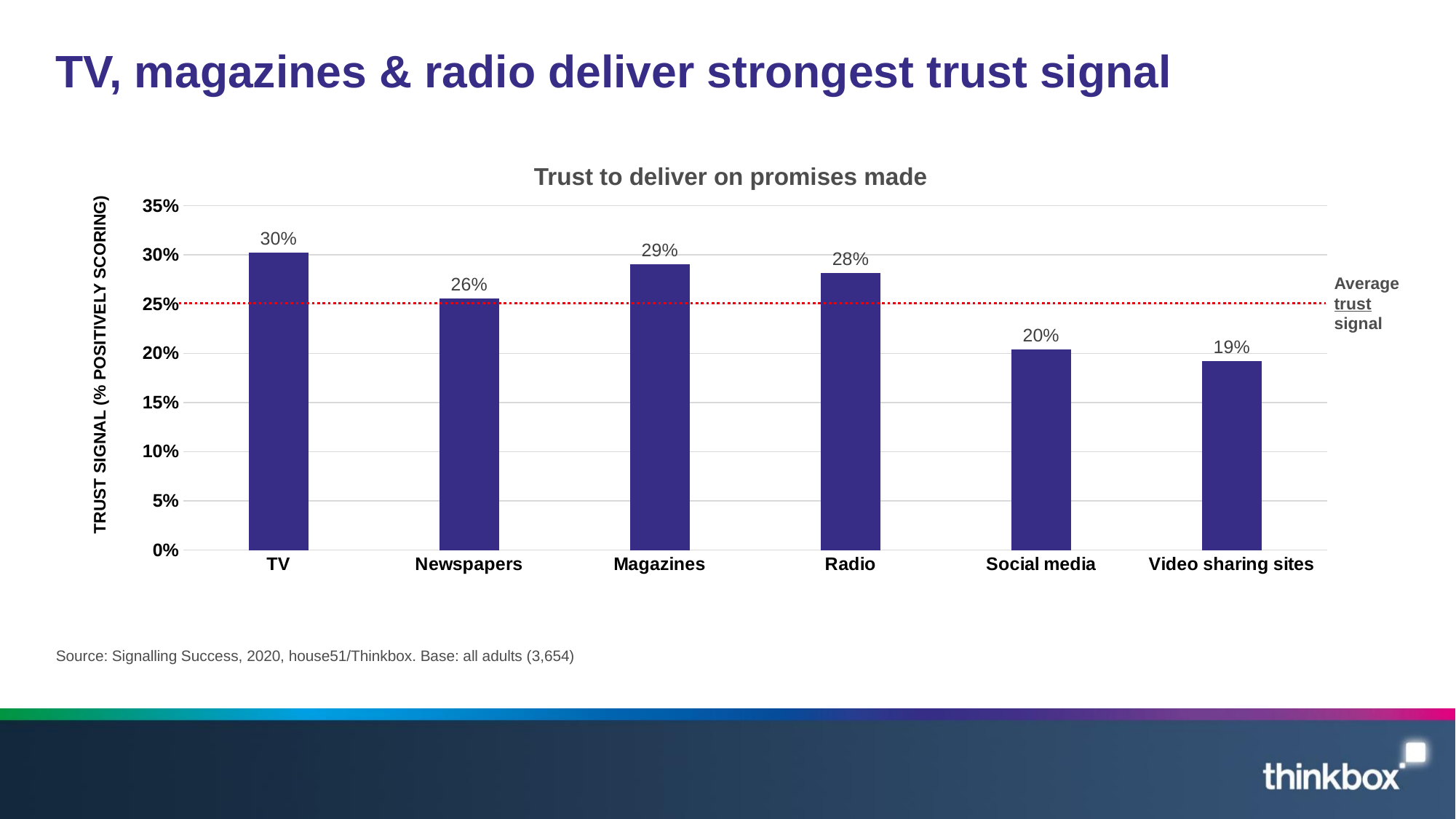
Is the value for Social media greater or less than 25%? less What is the trust signal value for Social media? 20% What is the difference between the trust signal for Magazines and for Social media? 9% Which category has the lowest trust signal? Video sharing sites Which has a higher trust signal, Radio or Newspapers? Radio What is the trust signal value for Newspapers? 26% Which category has the highest trust signal? TV How many categories are shown on the x axis? 6 What kind of chart is shown on the slide? Bar chart What is the title of the chart? Trust to deliver on promises made What is the difference between the trust signal for TV and for Video sharing sites? 11% What is the trust signal value for TV? 30%